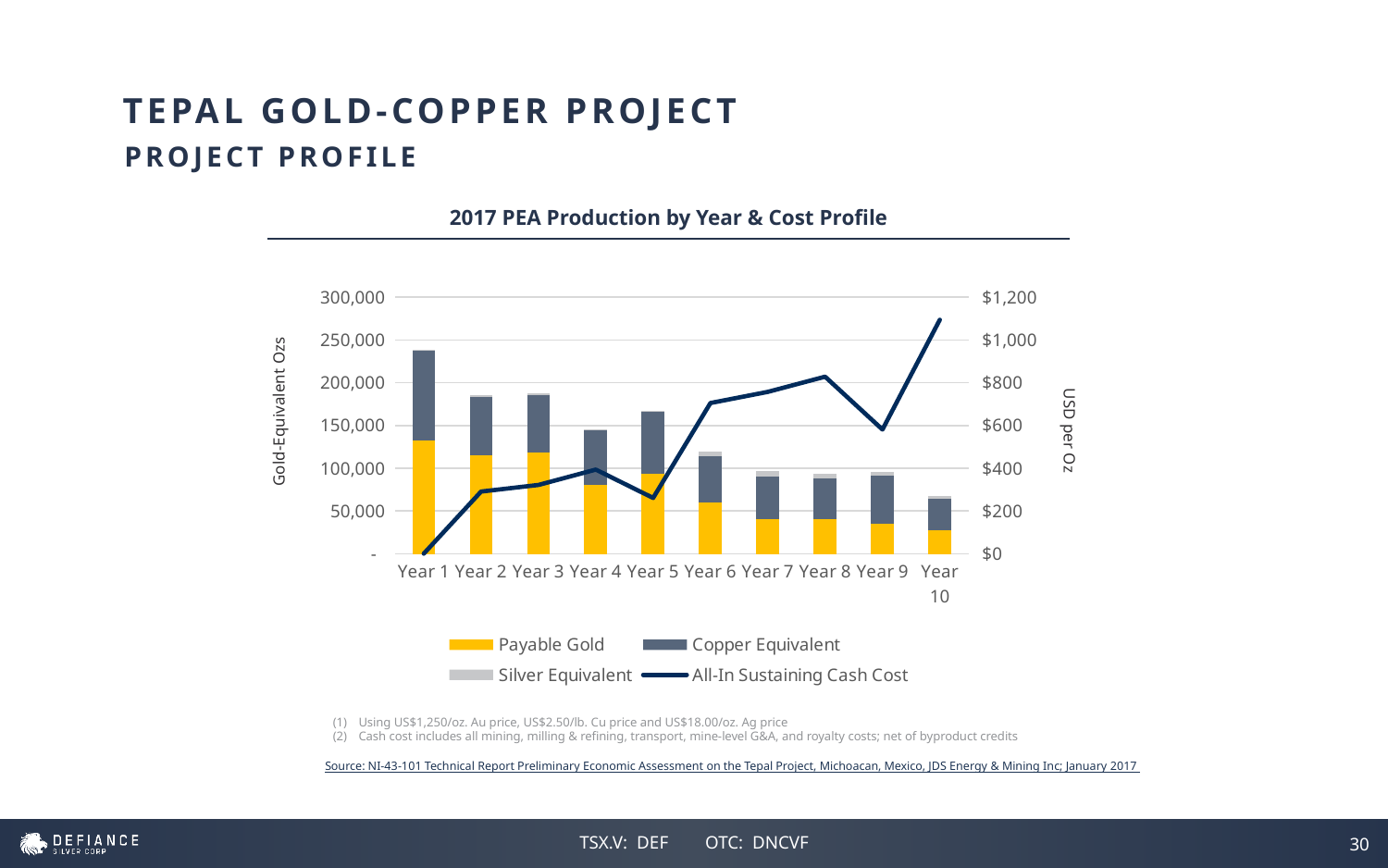
What kind of chart is shown on the slide? Stacked bar chart with a line Is the total gold-equivalent production for Year 1 greater or less than 200,000? greater Is the All-In Sustaining Cash Cost for Year 6 greater or less than $600? greater Is the All-In Sustaining Cash Cost for Year 10 greater or less than $1,000? greater How many years are shown on the x axis? 10 In which year is the All-In Sustaining Cash Cost highest? Year 10 Which year has the highest total gold-equivalent production? Year 1 Which year has a larger total gold-equivalent production, Year 1 or Year 4? Year 1 Which year has the lowest total gold-equivalent production? Year 10 How many series does the legend list? 4 What is the title of the chart? 2017 PEA Production by Year & Cost Profile